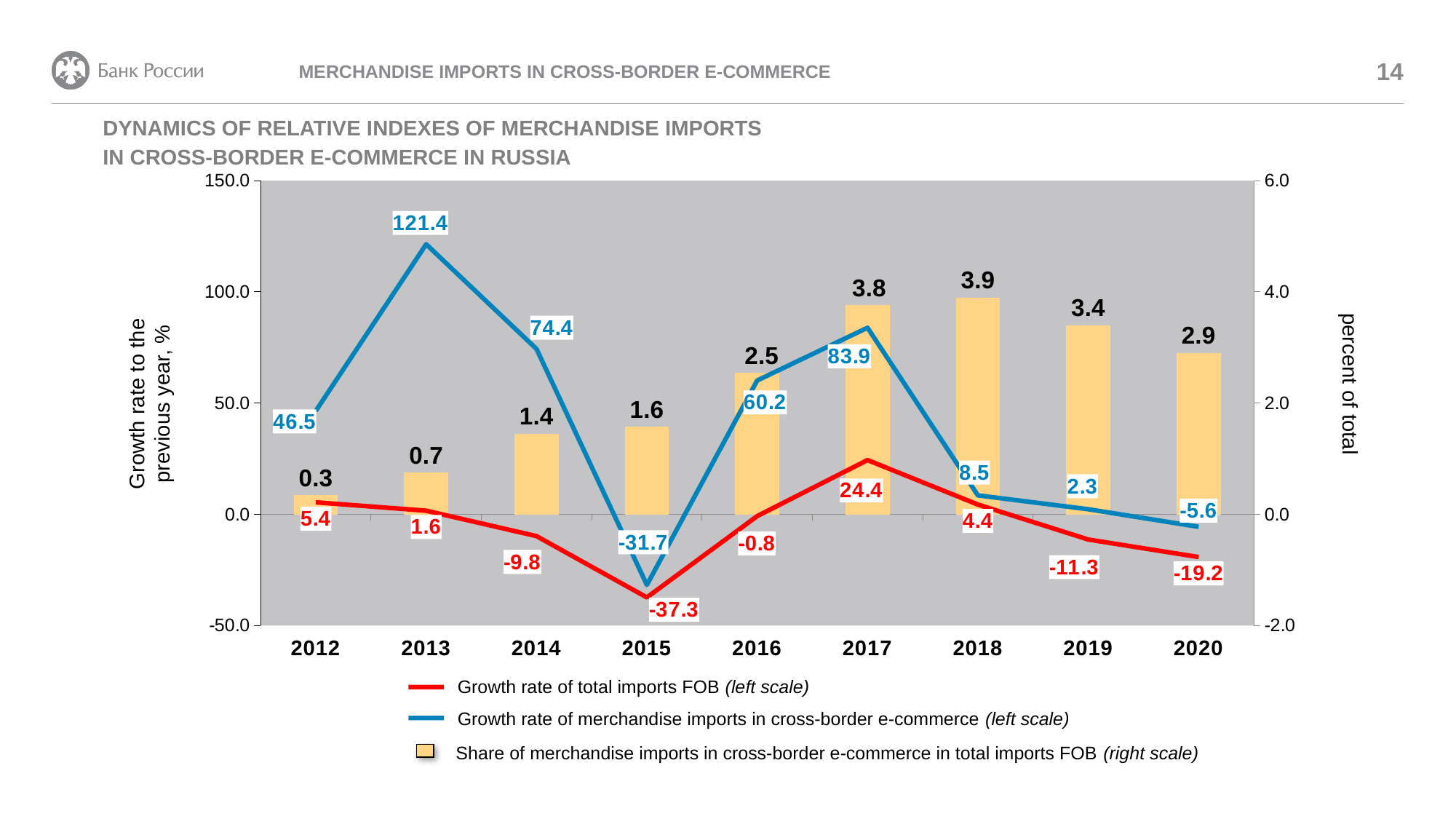
In which year is the growth rate of total imports FOB lowest? 2015 How many years are shown on the x axis? 9 What is the label of the right-hand vertical axis? percent of total What is the share of merchandise imports in cross-border e-commerce in total imports FOB in 2018? 3.9 How does the share of merchandise imports in cross-border e-commerce in total imports FOB change from 2018 to 2020? It falls Which is larger in 2019: the growth rate of total imports FOB or the growth rate of merchandise imports in cross-border e-commerce? Growth rate of merchandise imports in cross-border e-commerce In which year is the growth rate of merchandise imports in cross-border e-commerce highest? 2013 What is the growth rate of merchandise imports in cross-border e-commerce in 2013? 121.4 How many series does the legend list? 3 What is the growth rate of total imports FOB in 2015? -37.3 In which year is the share of merchandise imports in cross-border e-commerce in total imports FOB lowest? 2012 What is the difference between the growth rate of merchandise imports in cross-border e-commerce and the growth rate of total imports FOB in 2017? 59.5